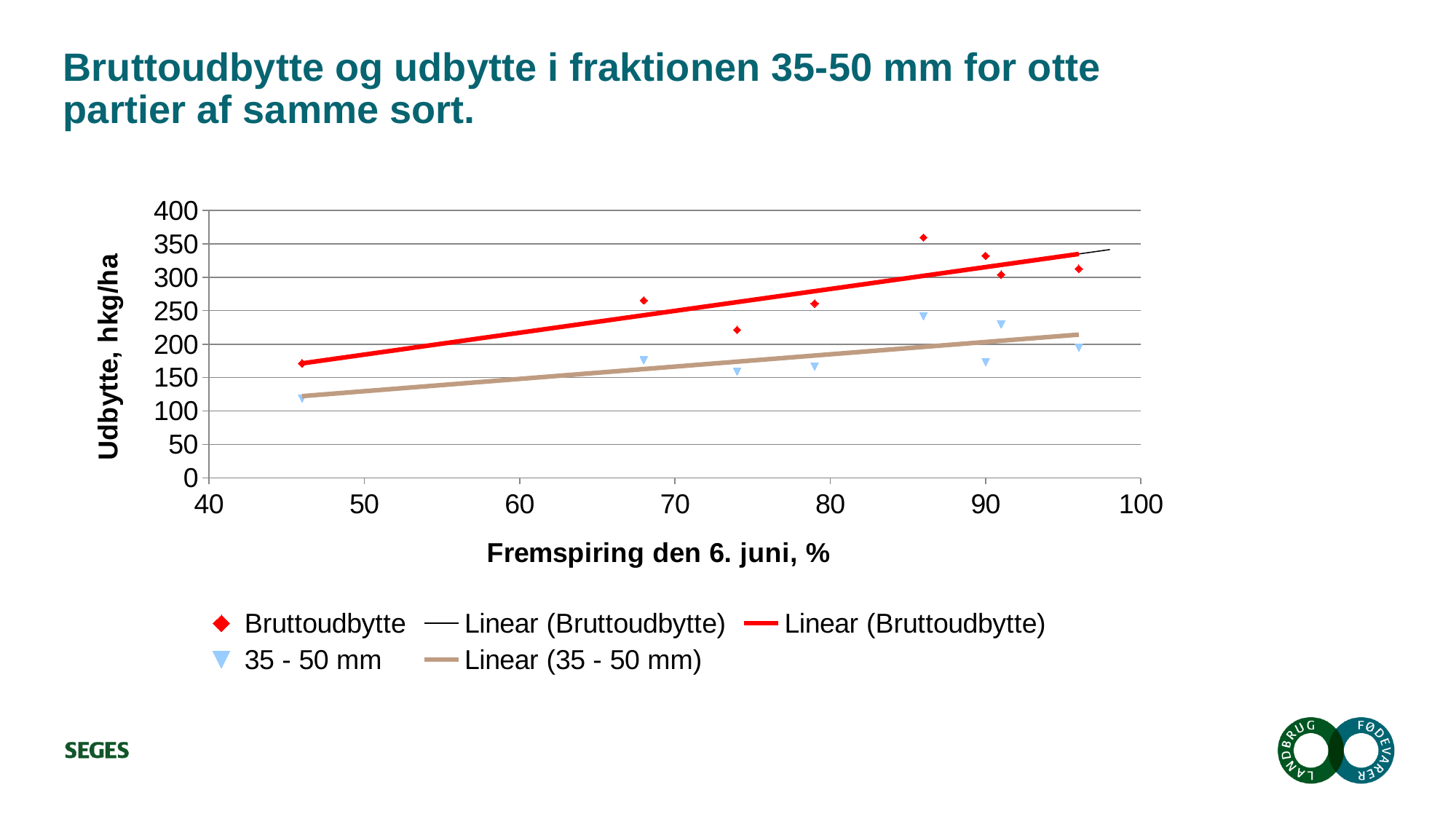
Which series is plotted with red diamond markers? Bruttoudbytte How many entries does the chart legend list? 5 Is the highest Bruttoudbytte point greater or less than 350? greater How many Bruttoudbytte data points are plotted in the chart? 8 What is the title of the horizontal axis? Fremspiring den 6. juni, % Is the highest 35 - 50 mm point greater or less than 250? less What kind of chart is shown on the slide? scatter chart Is the 35 - 50 mm value at the lowest Fremspiring (about 46%) greater or less than 100? greater Do the Bruttoudbytte values generally rise or fall as Fremspiring increases along the x axis? rise At a Fremspiring of about 96%, which series has the larger value, Bruttoudbytte or 35 - 50 mm? Bruttoudbytte What is the title of the vertical axis? Udbytte, hkg/ha